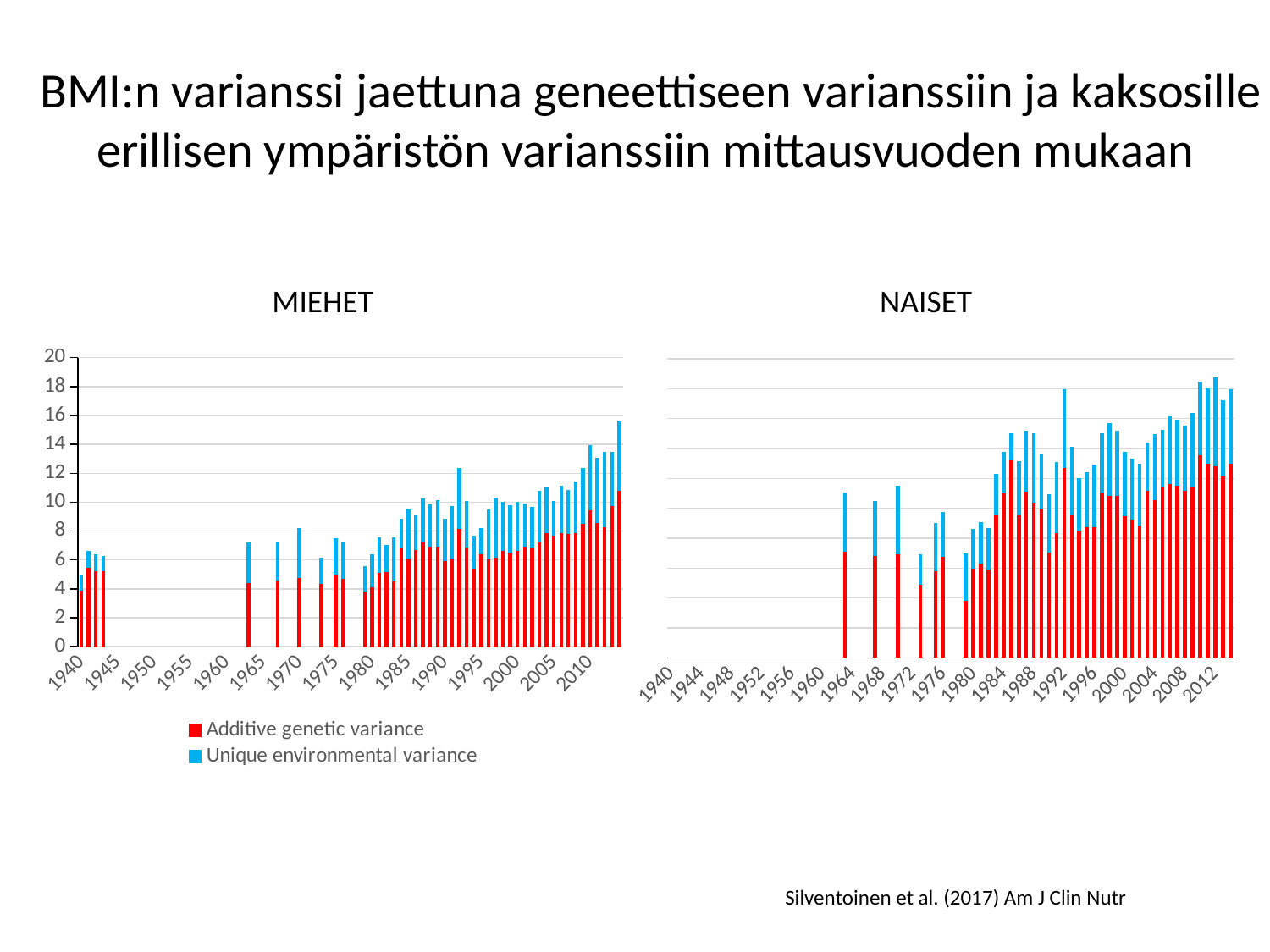
In the NAISET chart, do the bar totals generally rise or fall from 1980 to 2012? rise How many series does the legend list? 2 In the MIEHET chart, is the total value of the bar at 1980 greater or less than 10? less In the MIEHET chart, do the bar totals generally rise or fall from 1980 to 2010? rise In the MIEHET chart, is the total value of the bar at 1940 greater or less than 10? less In the MIEHET chart, which bar has the larger total: 1940 or 2010? 2010 In the MIEHET chart, is the Additive genetic variance value at 2010 greater or less than 6? greater Which series is shown in red in the legend? Additive genetic variance Which series is shown in blue in the legend? Unique environmental variance What kind of chart is the MIEHET chart? Stacked bar chart